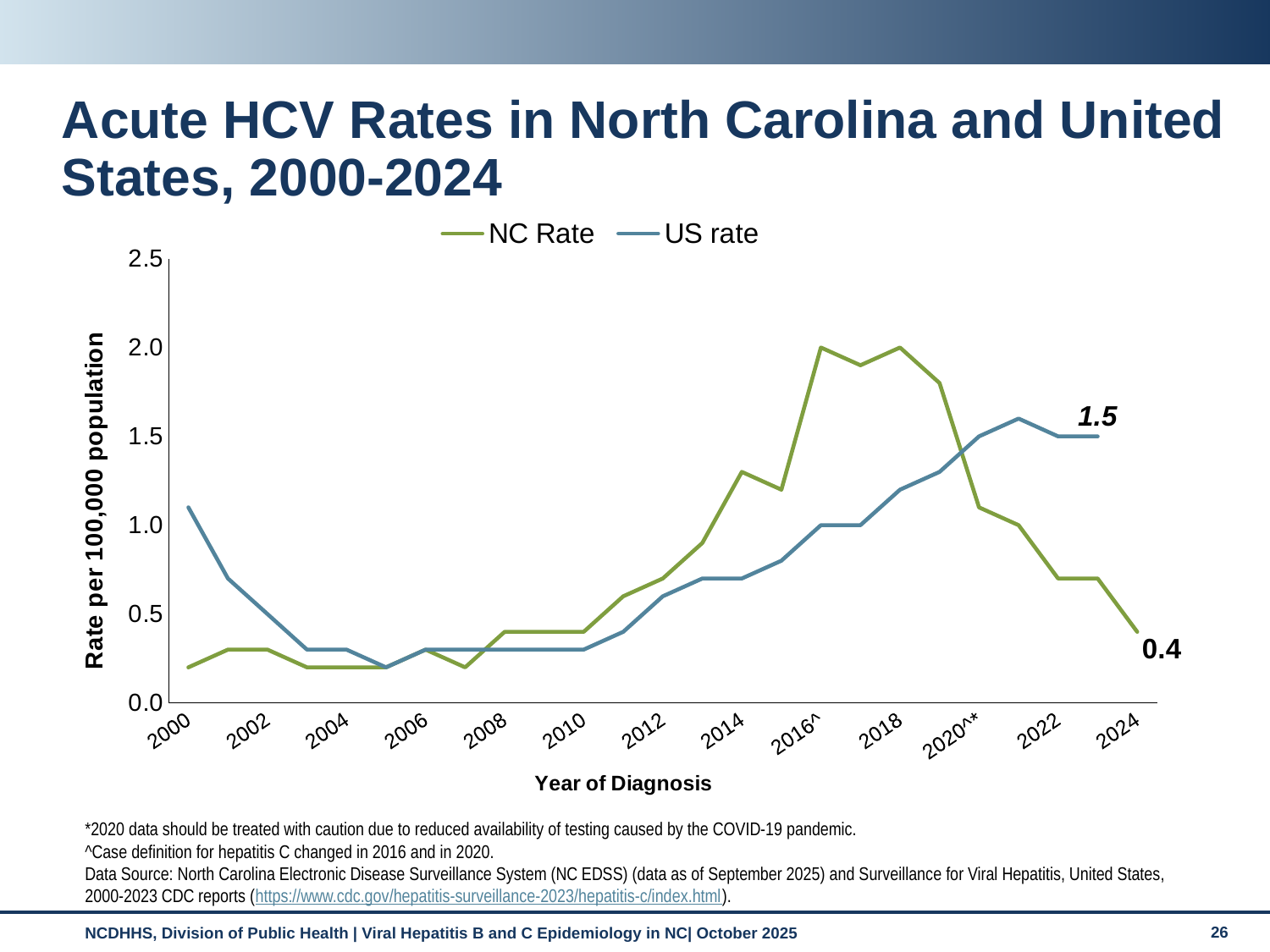
What kind of chart is shown on the slide? Line chart Is the NC Rate value for 2016^ greater or less than 1.5? greater What is the difference between the two labeled end values, 1.5 for US rate and 0.4 for NC Rate? 1.1 Does the NC Rate rise or fall from 2018 to 2024? Fall Is the NC Rate value for 2004 greater or less than 0.5? less How many series does the legend list? 2 What is the labeled value at the end of the US rate line? 1.5 In 2016^, which series has the higher value, NC Rate or US rate? NC Rate Which of the two labeled end values is larger, the US rate (1.5) or the NC Rate (0.4)? US rate Is the US rate value for 2000 greater or less than 0.5? greater What is the labeled value at the end of the NC Rate line (2024)? 0.4 In 2022, which series has the higher value, NC Rate or US rate? US rate